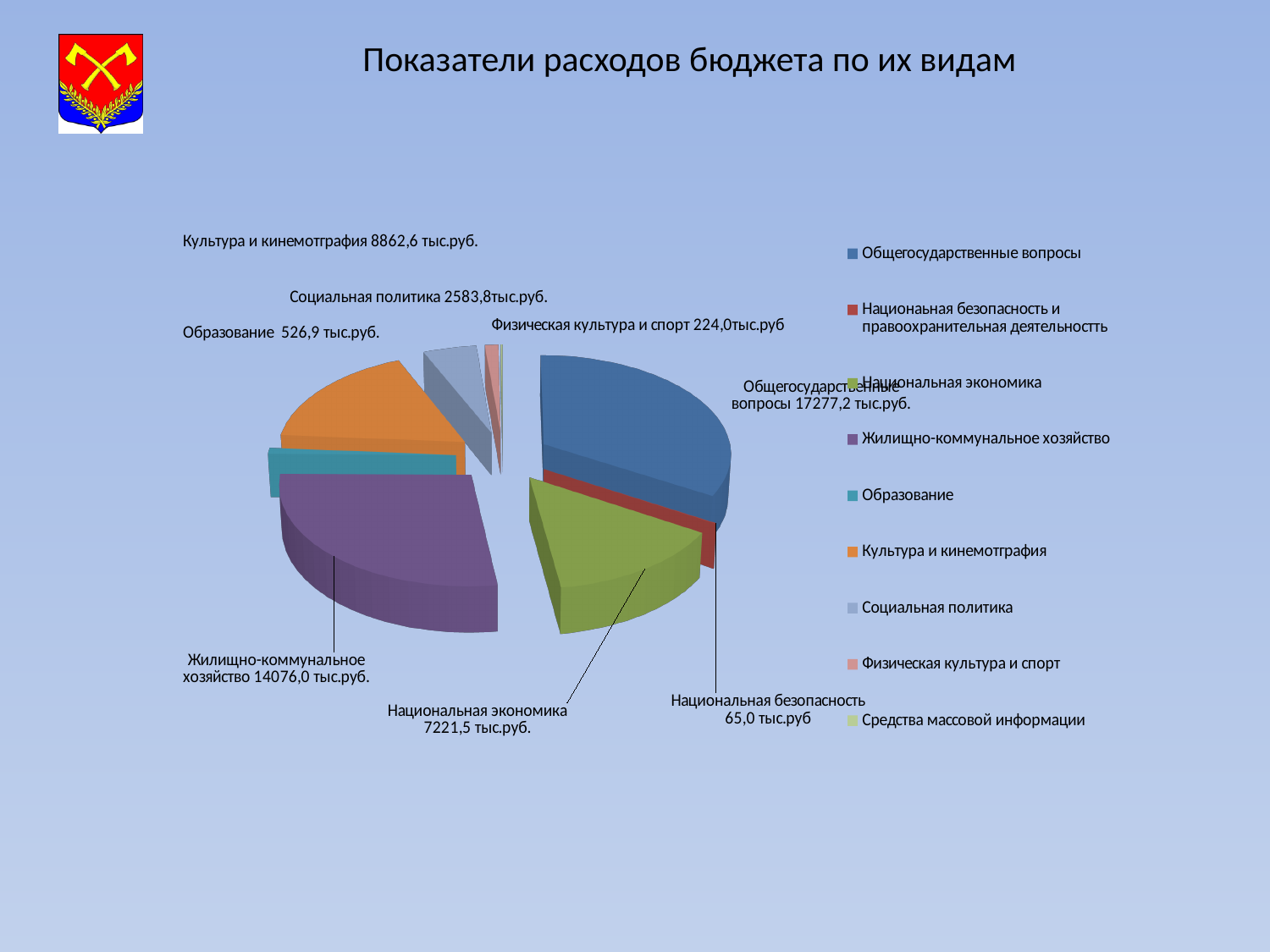
How many categories does the legend of the pie chart list? 9 What is the value labelled for Культура и кинемотграфия? 8862,6 тыс.руб. What is the title of the slide's chart? Показатели расходов бюджета по их видам Which is larger: Жилищно-коммунальное хозяйство or Национальная экономика? Жилищно-коммунальное хозяйство What kind of chart is shown on the slide? pie chart What is the value labelled for Национальная безопасность? 65,0 тыс.руб What is the value labelled for Общегосударственные вопросы? 17277,2 тыс.руб. What is the difference between the values for Общегосударственные вопросы and Жилищно-коммунальное хозяйство? 3201,2 тыс.руб. Which category has the largest slice of the pie? Общегосударственные вопросы What is the value labelled for Национальная экономика? 7221,5 тыс.руб. What is the value labelled for Жилищно-коммунальное хозяйство? 14076,0 тыс.руб. What is the value labelled for Образование? 526,9 тыс.руб.